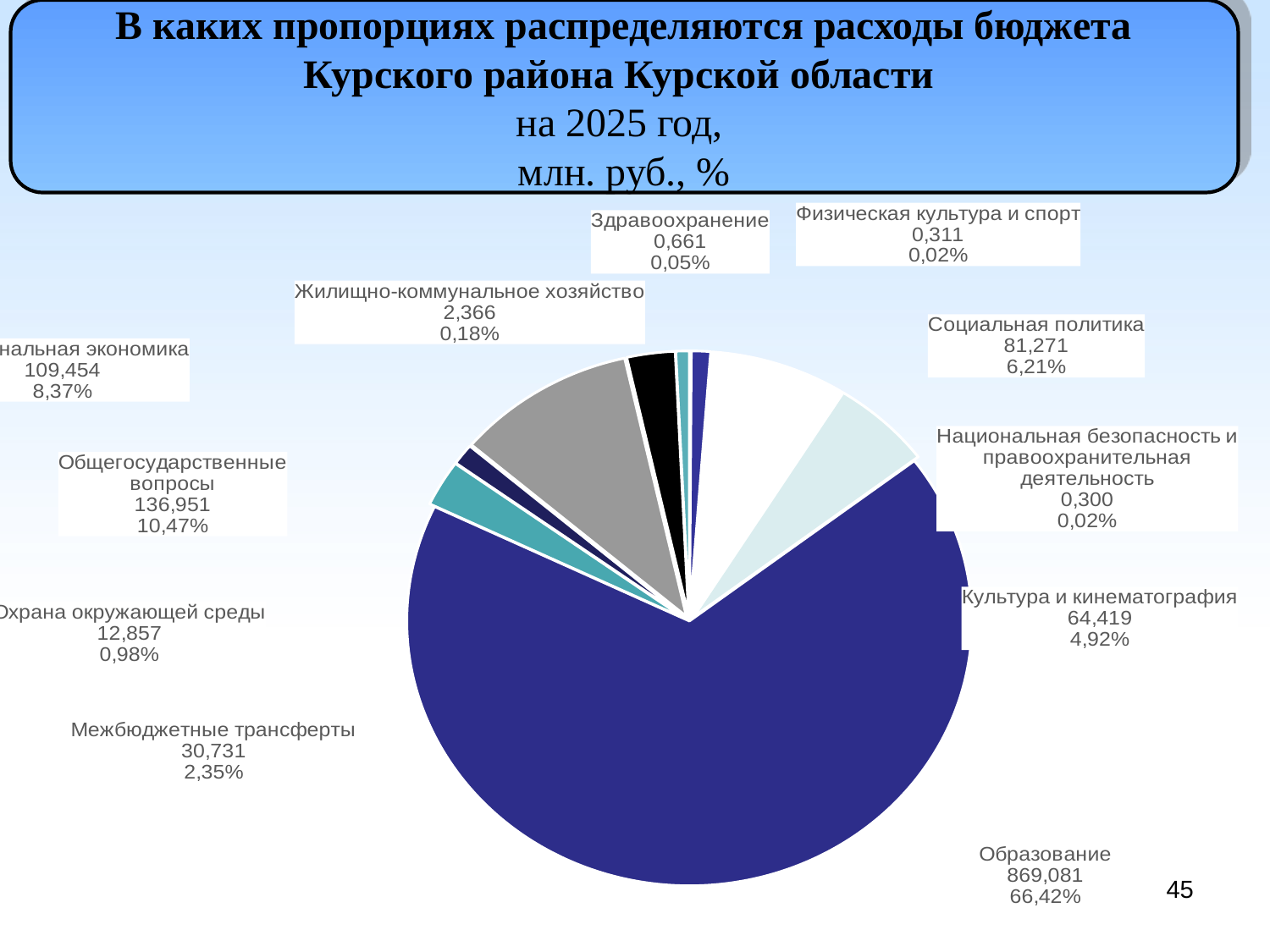
What percentage is shown for Общегосударственные вопросы? 10,47% What is the value for Образование? 869,081 Which category has the largest value? Образование What type of chart is shown on the slide? pie chart What is the difference between Общегосударственные вопросы and Социальная политика? 55,680 What is the value for Социальная политика? 81,271 Which is larger, Культура и кинематография or Социальная политика? Социальная политика What share of the pie does Образование take? 66,42% How many slices does the pie chart have? 11 What is the value for Межбюджетные трансферты? 30,731 What is the difference between Межбюджетные трансферты and Охрана окружающей среды? 17,874 Which category has the smallest value? Национальная безопасность и правоохранительная деятельность